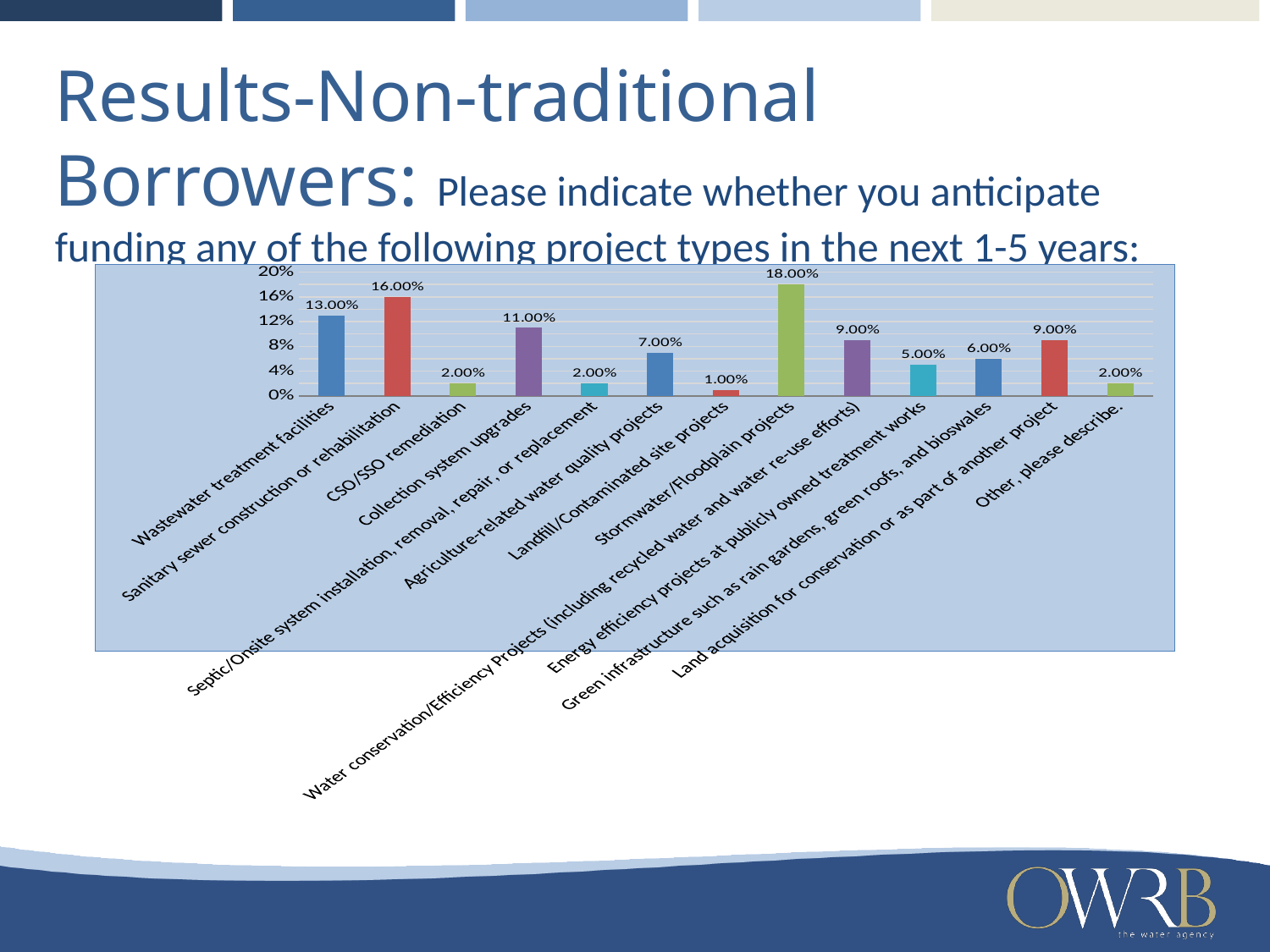
What is the value for Energy efficiency projects at publicly owned treatment works? 5.00% What is the maximum value shown on the vertical axis of the chart? 20% Is the value for Wastewater treatment facilities greater or less than 12%? greater What is the value for Stormwater/Floodplain projects? 18.00% What is the value for Collection system upgrades? 11.00% How many project-type categories are plotted in the chart? 13 What is the difference between the values for Stormwater/Floodplain projects and Wastewater treatment facilities? 5.00% Which is larger, the value for Agriculture-related water quality projects or the value for Green infrastructure such as rain gardens, green roofs, and bioswales? Agriculture-related water quality projects What kind of chart is shown on the slide? bar chart What is the value for Sanitary sewer construction or rehabilitation? 16.00% Which project type has the highest value? Stormwater/Floodplain projects Which project type has the lowest value? Landfill/Contaminated site projects